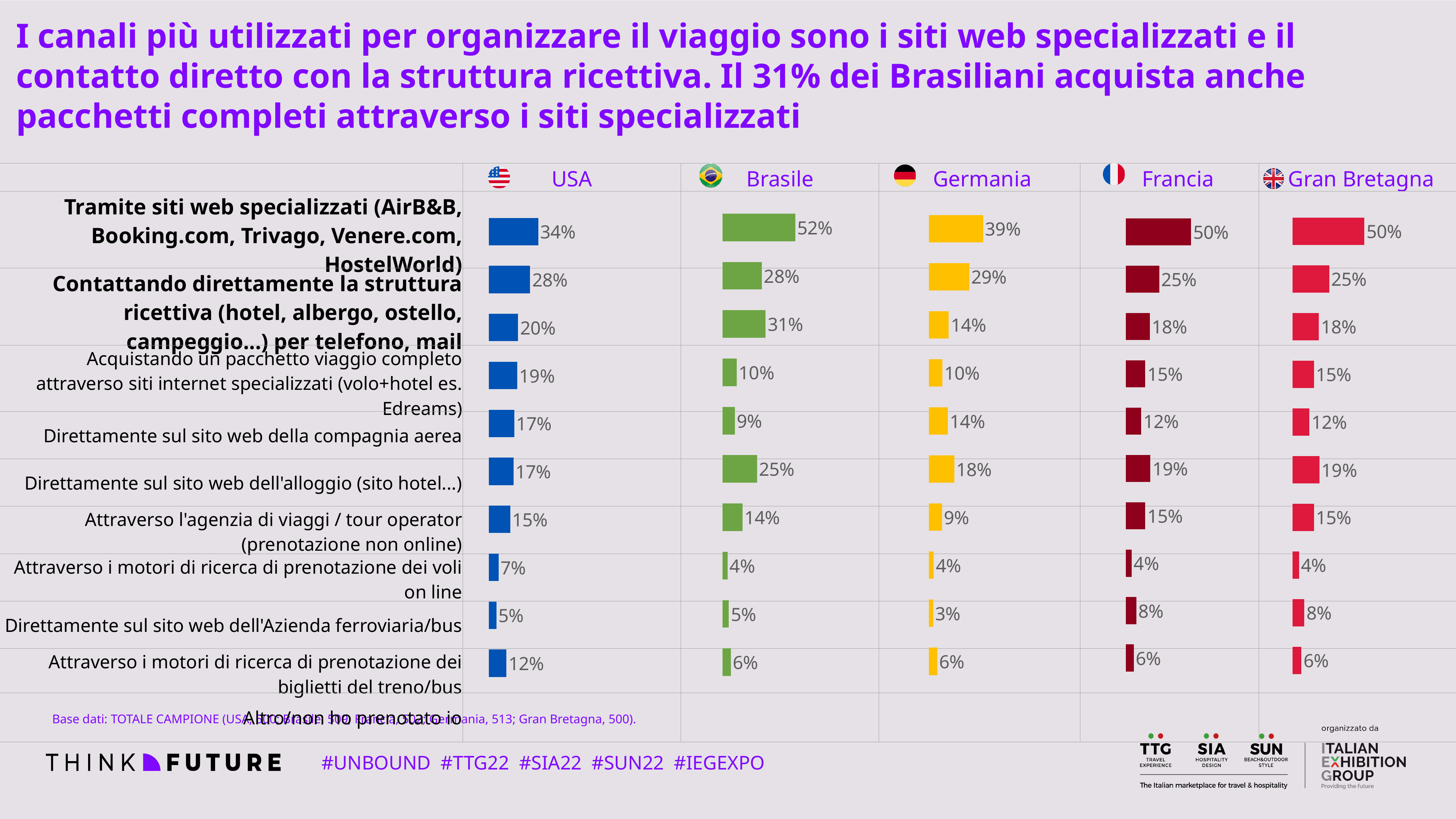
In the USA chart, what is the highest value shown? 34% In the USA chart, what is the value for "Contattando direttamente la struttura ricettiva"? 28% In the Germania chart, what is the value for "Acquistando un pacchetto viaggio completo attraverso siti internet specializzati"? 14% What colour are the bars in the Brasile chart? Green Across the five country charts, which country has the highest value for "Tramite siti web specializzati"? Brasile What is the difference between the Brasile and USA values for "Tramite siti web specializzati"? 18 percentage points How many channel categories (rows) are shown in each country chart? 10 How many countries have their own bar chart on the slide? 5 In the Germania chart, what is the lowest value shown? 3% In the Brasile chart, what is the value for "Tramite siti web specializzati (AirB&B, Booking.com, Trivago, Venere.com, HostelWorld)"? 52% For "Tramite siti web specializzati", which is larger: the Francia value or the Germania value? Francia What kind of chart is used to show the values for each country? Bar chart